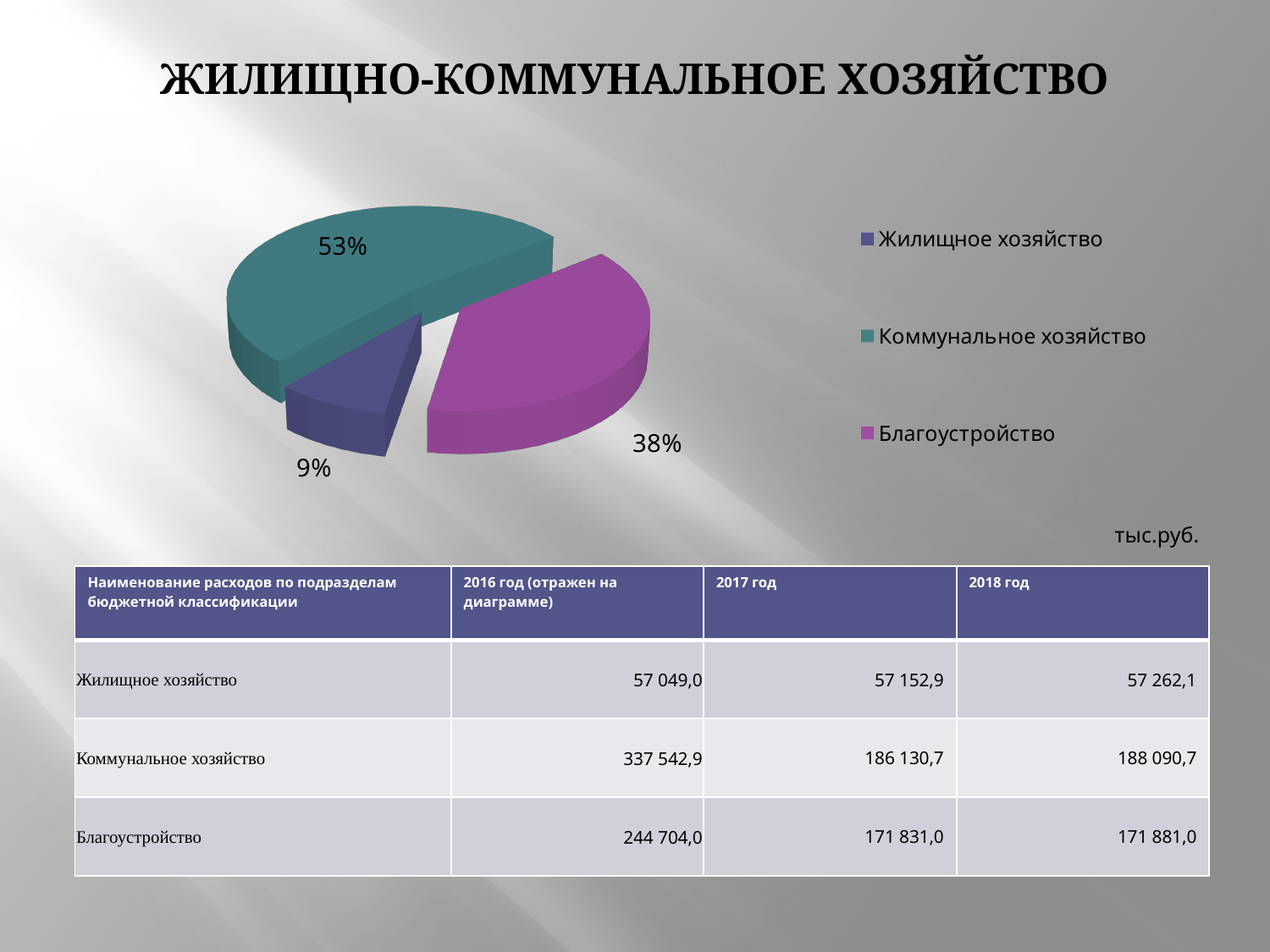
Which category has the largest slice of the pie? Коммунальное хозяйство What is the difference in percentage points between the Коммунальное хозяйство slice and the Благоустройство slice? 15 Which slice is larger, Благоустройство or Жилищное хозяйство? Благоустройство Which legend entry is shown in teal? Коммунальное хозяйство Which category has the smallest slice of the pie? Жилищное хозяйство How many entries does the legend list? 3 What share of the pie does Жилищное хозяйство have? 9% How many slices does the pie chart have? 3 What share of the pie does Коммунальное хозяйство have? 53% What kind of chart is shown on the slide? Pie chart What share of the pie does Благоустройство have? 38% What colour is the Благоустройство slice in the pie chart? Purple